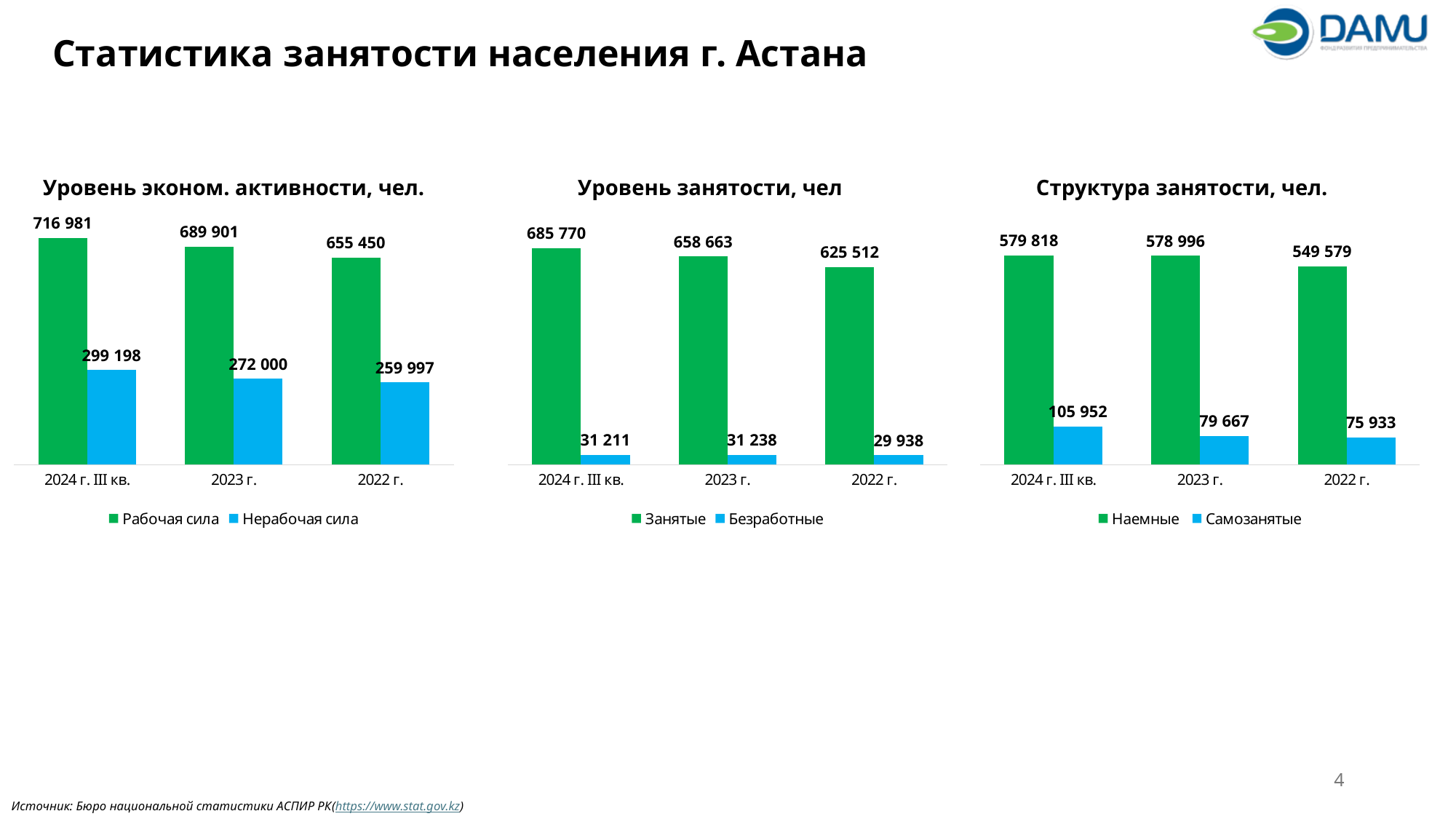
What type of chart is 'Уровень занятости, чел'? bar chart In the chart 'Структура занятости, чел.', which period has the lowest value of Самозанятые? 2022 г. In the chart 'Структура занятости, чел.', what is the difference between Самозанятые in 2024 г. III кв. and 2023 г.? 26 285 In the chart 'Уровень эконом. активности, чел.', does Рабочая сила rise or fall from 2024 г. III кв. to 2022 г. along the x axis? fall In the chart 'Уровень занятости, чел', which period has the highest value of Занятые? 2024 г. III кв. In the chart 'Уровень эконом. активности, чел.', what is the value of Рабочая сила for 2024 г. III кв.? 716 981 In the chart 'Уровень эконом. активности, чел.', what is the value of Нерабочая сила for 2023 г.? 272 000 In the chart 'Уровень занятости, чел', how much higher is Занятые in 2024 г. III кв. than in 2022 г.? 60 258 How many series does the legend of the chart 'Структура занятости, чел.' list? 2 In the chart 'Структура занятости, чел.', what is the value of Самозанятые for 2024 г. III кв.? 105 952 In the chart 'Уровень занятости, чел', what is the value of Безработные for 2022 г.? 29 938 In the chart 'Уровень эконом. активности, чел.', what is the difference between Рабочая сила and Нерабочая сила for 2024 г. III кв.? 417 783